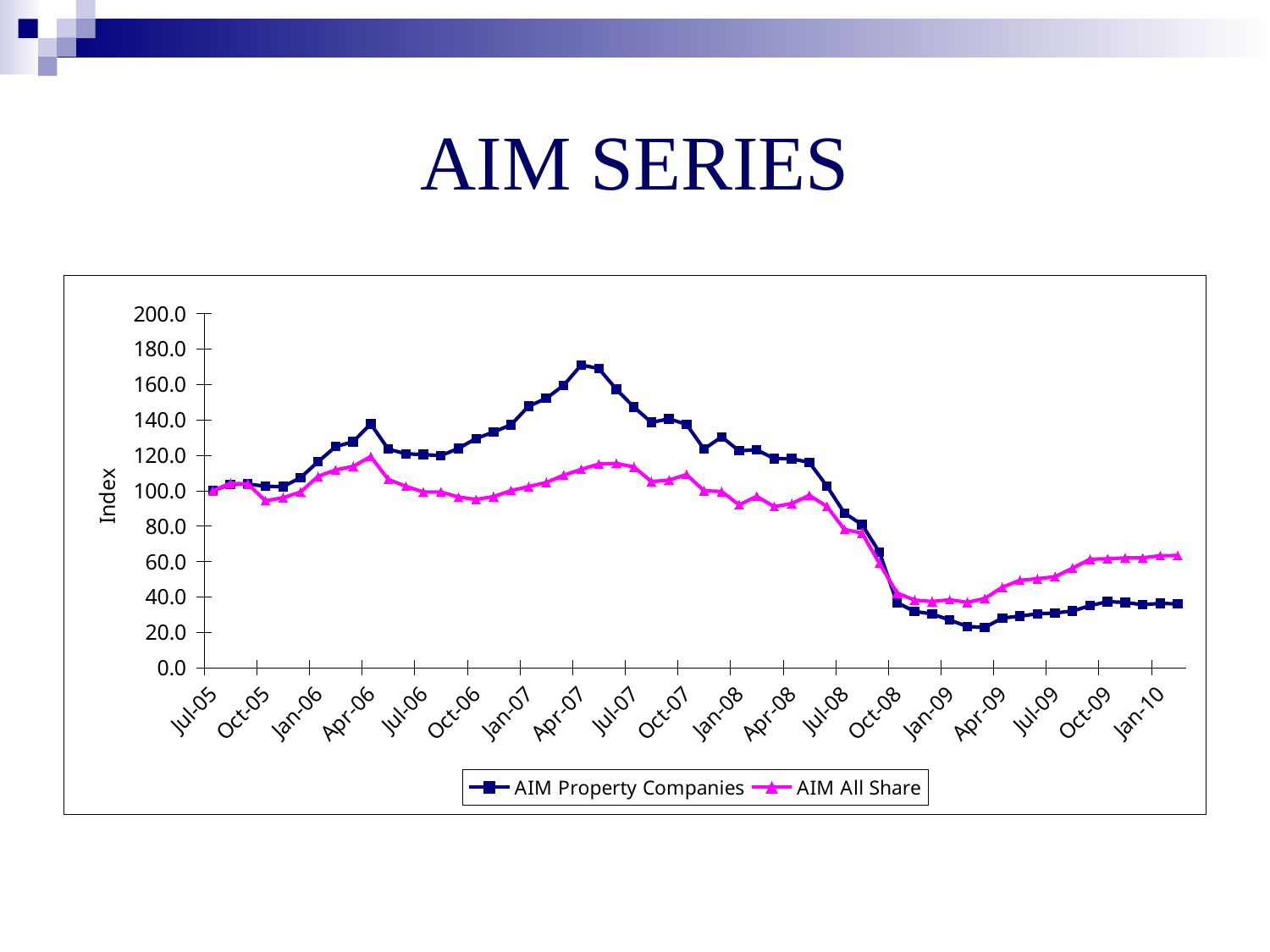
What is the label on the vertical axis? Index At Apr-07, which series has the higher value, AIM Property Companies or AIM All Share? AIM Property Companies Is the value for AIM All Share at Jan-09 greater or less than 60? less Is the value for AIM Property Companies at Apr-09 greater or less than 40? less How many date labels are shown along the x axis? 19 Is the value for AIM All Share at Jan-10 greater or less than 40? greater What are the two series named in the legend? AIM Property Companies and AIM All Share How many series does the legend list? 2 At Jan-10, which series has the higher value, AIM Property Companies or AIM All Share? AIM All Share Does the AIM Property Companies series rise or fall between Apr-07 and Apr-09? fall What kind of chart is shown on the slide? line chart